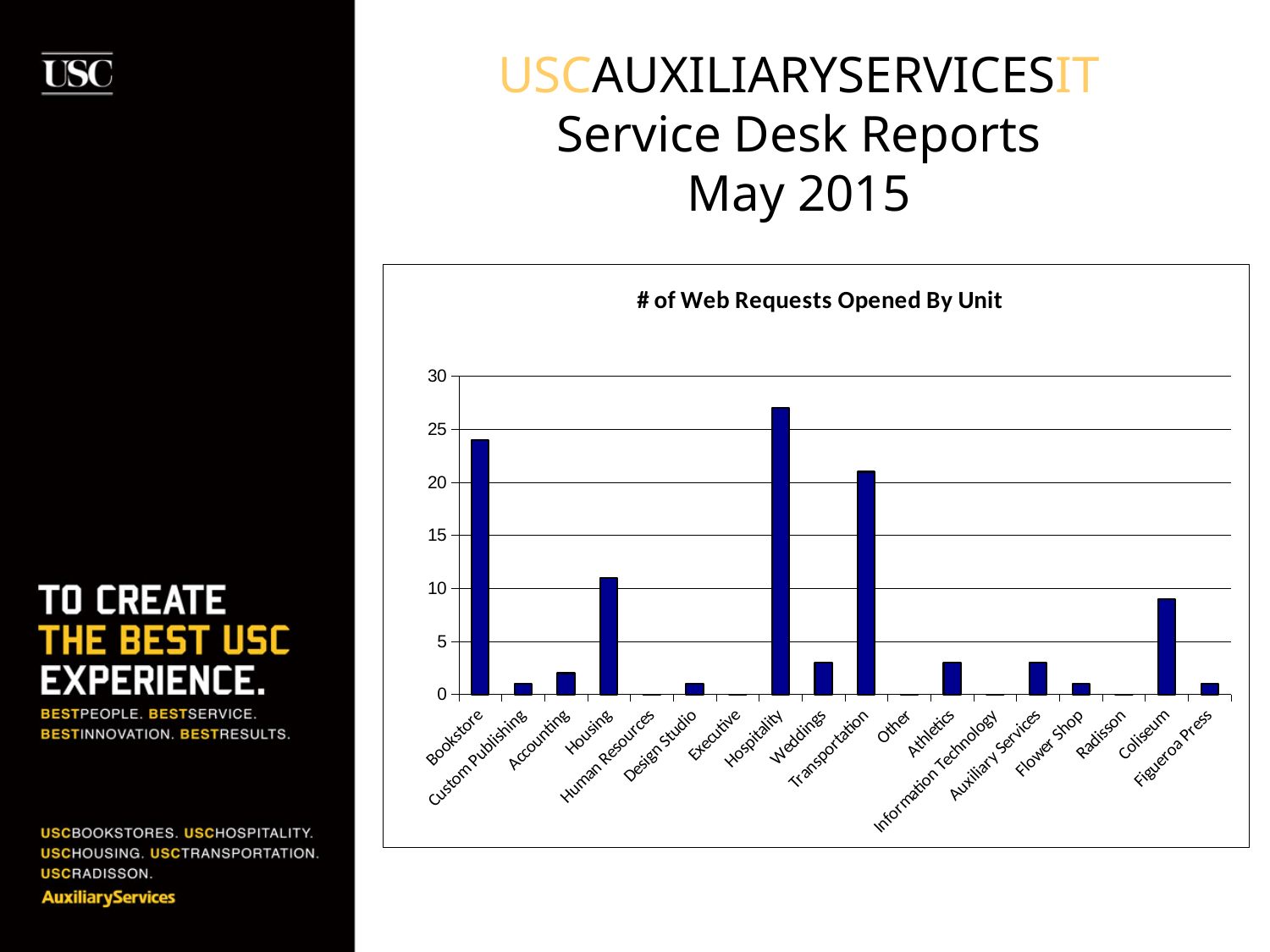
Is the value for Coliseum greater or less than 10? less Which has more web requests opened, Bookstore or Transportation? Bookstore Which unit has the highest number of web requests opened? Hospitality Which has more web requests opened, Housing or Coliseum? Housing What kind of chart is shown on the slide? bar chart Is the value for Transportation greater or less than 25? less How many units (categories) are shown on the x axis of the chart? 18 Is the value for Weddings greater or less than 5? less What is the title of the chart? # of Web Requests Opened By Unit